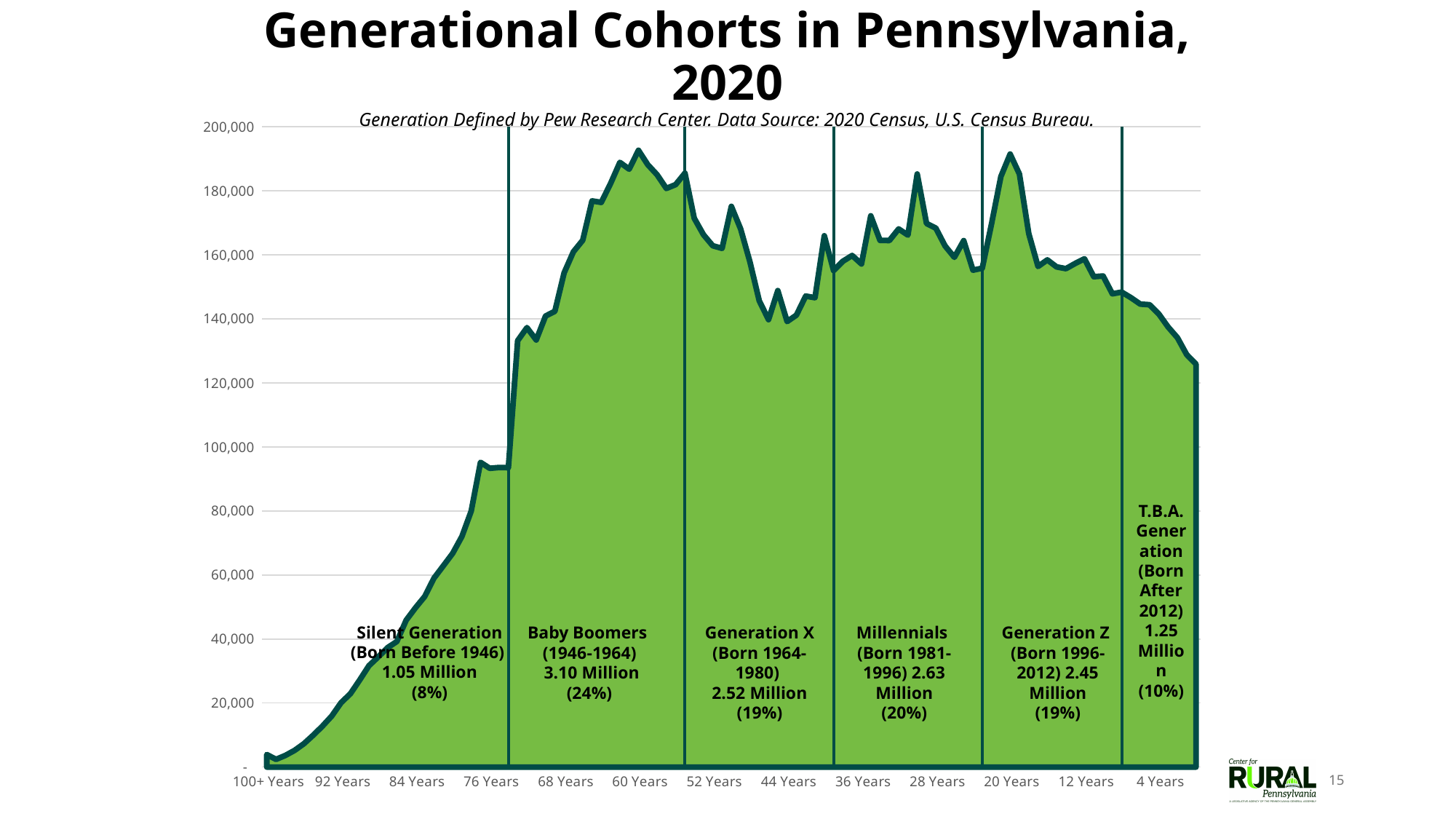
What is the population of Baby Boomers in Pennsylvania according to the chart annotation? 3.10 Million Which generational cohort has the largest population? Baby Boomers What kind of chart is shown on the slide? Area chart What percentage of Pennsylvania's population are Millennials? 20% Is the value for 4 Years greater or less than 120,000? greater What is the difference in population between Baby Boomers (3.10 Million) and Generation X (2.52 Million)? 0.58 Million What is the title of the chart? Generational Cohorts in Pennsylvania, 2020 Which cohort has a larger population, Millennials or Generation Z? Millennials How many generational cohorts are labeled on the chart? 6 Do the values rise or fall along the x axis from 100+ Years to 60 Years? rise Is the value for 100+ Years greater or less than 20,000? less Which generational cohort has the smallest population? Silent Generation